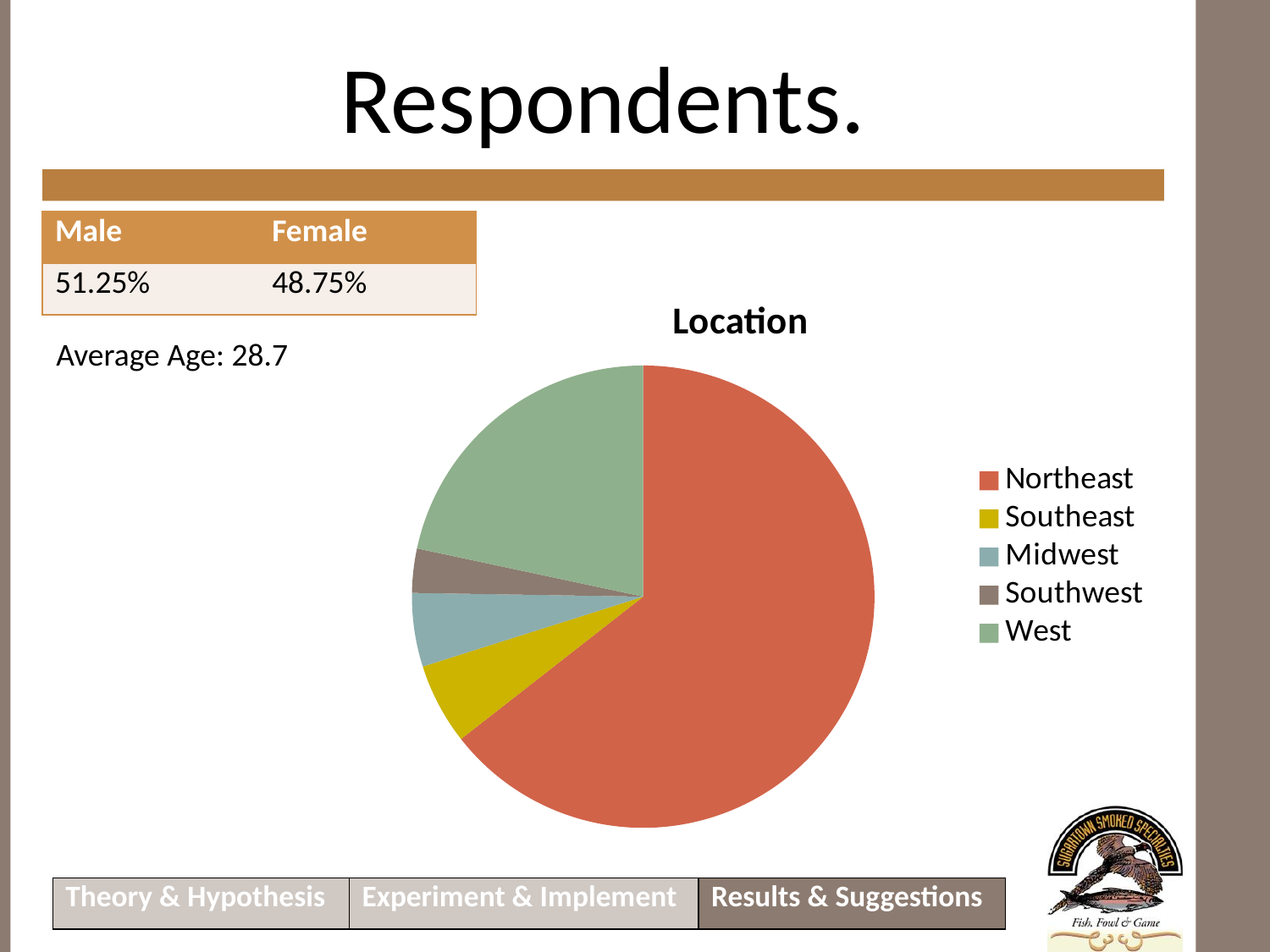
Which location has the largest slice of the pie chart? Northeast Which slice is larger in the Location pie chart, Midwest or West? West How many slices does the Location pie chart have? 5 Which location has the smallest slice of the pie chart? Southwest What is the title of the pie chart? Location Which location is shown in green in the Location pie chart? West Which slice is larger in the Location pie chart, West or Southeast? West How many entries does the legend of the Location pie chart list? 5 Which location has the second-largest slice of the pie chart? West Which slice is larger in the Location pie chart, Southwest or Northeast? Northeast What kind of chart is shown on the slide? pie chart